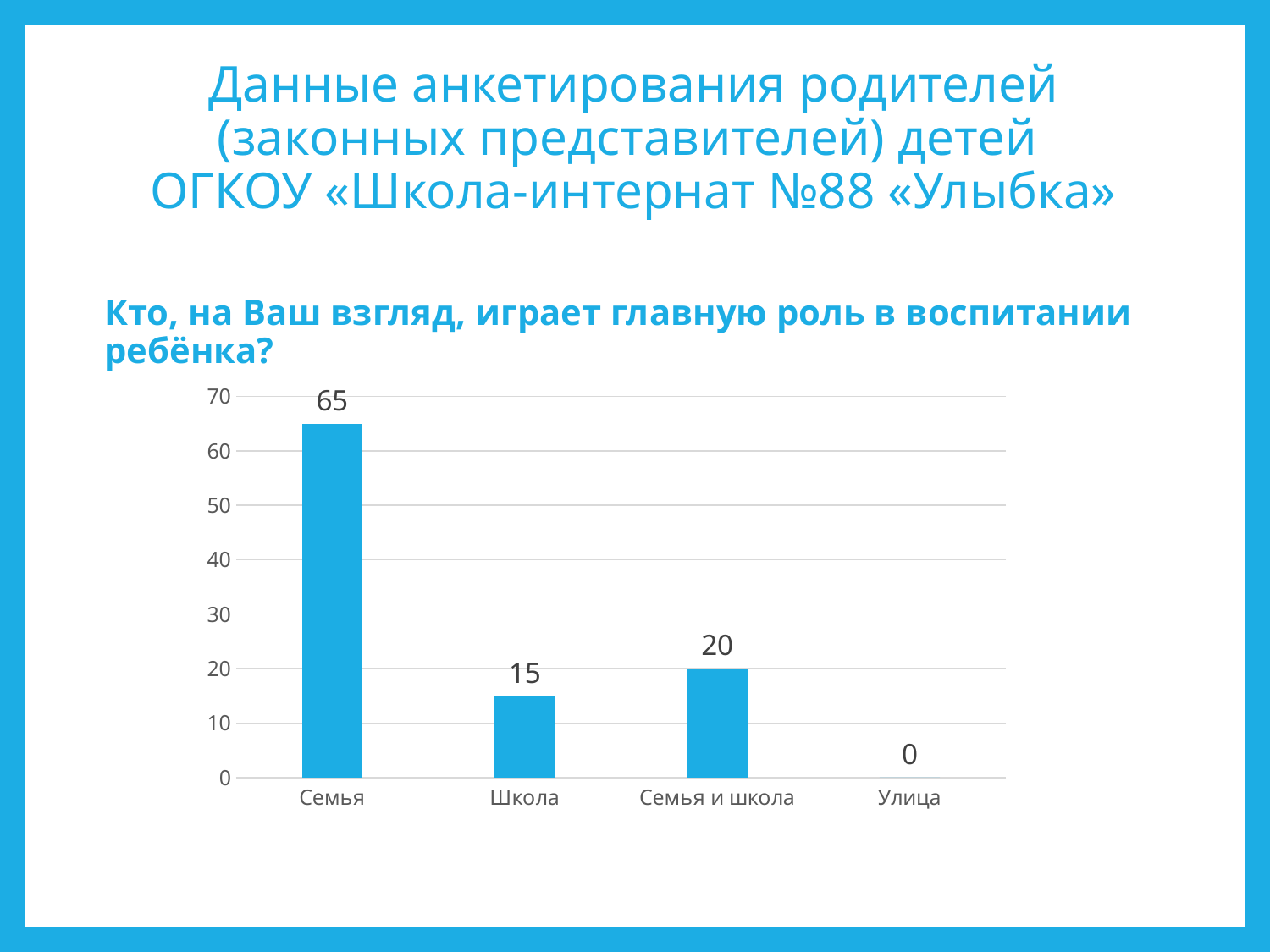
Which category has the highest value? Семья Which is larger, the value for Школа or the value for Семья и школа? Семья и школа What kind of chart is shown on the slide? bar chart What is the value for Семья и школа? 20 What is the value for Улица? 0 What is the value for Школа? 15 Which category has the lowest value? Улица How many categories are shown on the x axis? 4 What is the difference between the values for Семья and Семья и школа? 45 What question does the chart answer, according to the heading above it? Кто, на Ваш взгляд, играет главную роль в воспитании ребёнка? Is the value for Семья greater or less than 60? greater What is the value for Семья? 65